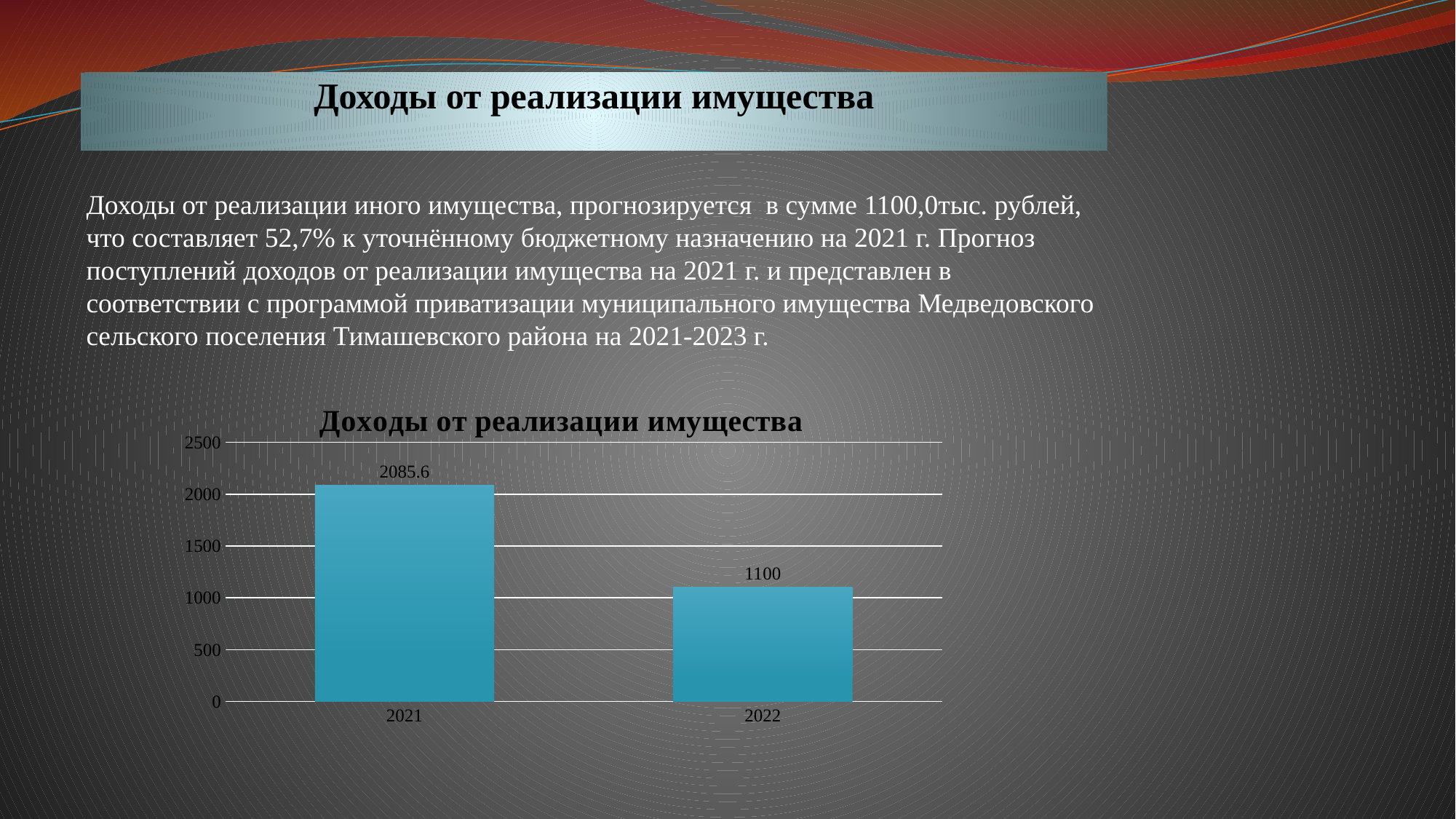
Is the value for 2022 greater or less than 1500? less Do the values rise or fall from 2021 to 2022? fall Which is larger, the value for 2021 or the value for 2022? 2021 What is the difference between the values for 2021 and 2022? 985.6 What is the value for 2021 in the chart? 2085.6 Which year has the highest value in the chart? 2021 What kind of chart is shown on the slide? bar chart How many categories are shown on the x axis of the chart? 2 What is the value for 2022 in the chart? 1100 Is the value for 2021 greater or less than 2000? greater What is the title of the chart? Доходы от реализации имущества Which year has the lowest value in the chart? 2022